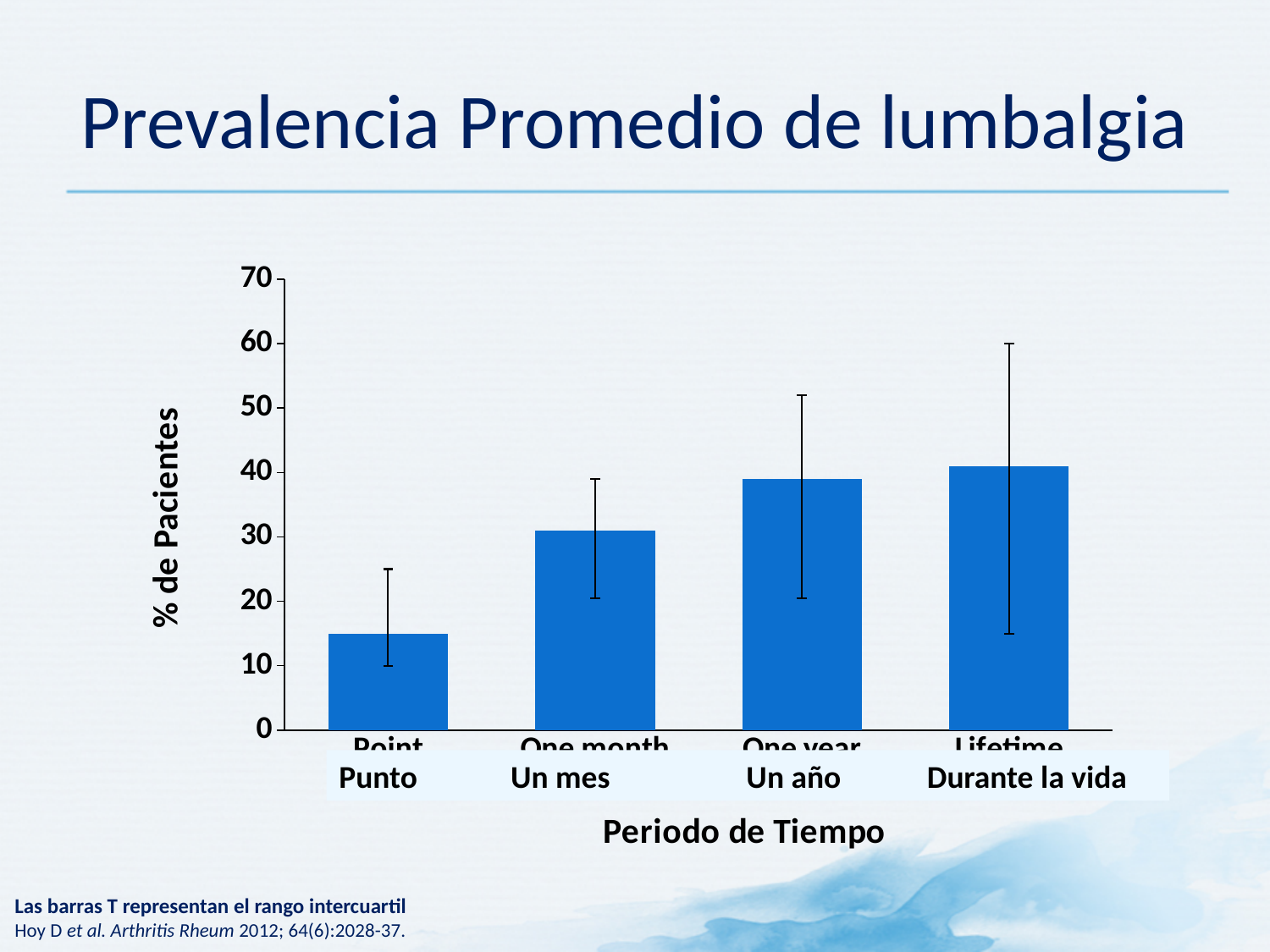
Is the value for Punto greater or less than 10? greater Is the value for Durante la vida greater or less than 50? less Which time period has the lowest prevalence of lumbalgia? Punto Is the value for Punto greater or less than 20? less How many time-period categories are plotted on the x axis? 4 Which is larger, the value for Punto or the value for Un mes? Un mes What kind of chart is shown on the slide? bar chart What is the label of the y axis? % de Pacientes Do the bar values rise or fall from Punto to Durante la vida along the x axis? rise Which is larger, the value for Un mes or the value for Un año? Un año